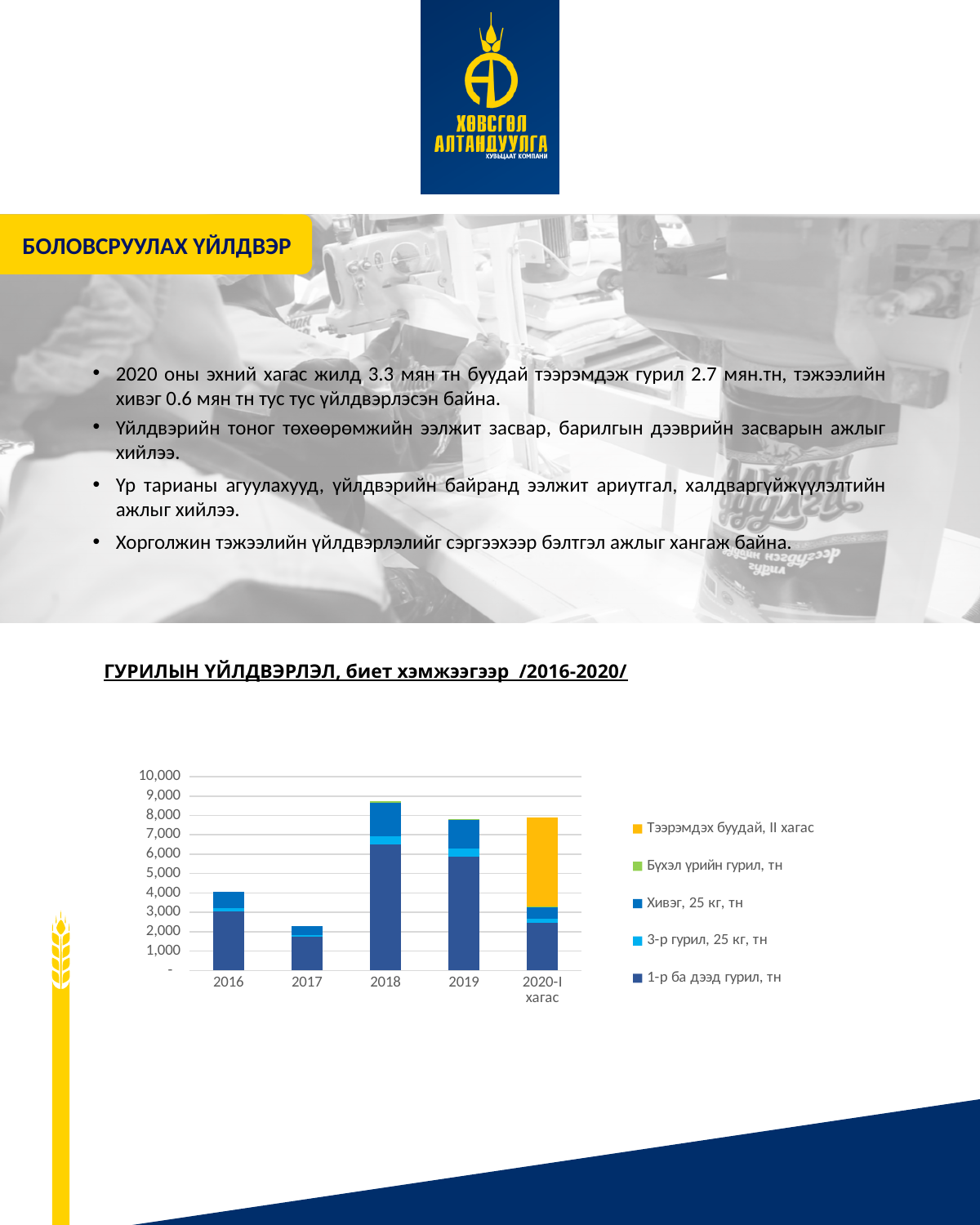
What is the title of the chart? ГУРИЛЫН ҮЙЛДВЭРЛЭЛ, биет хэмжээгээр /2016-2020/ Which has the larger total bar, 2018 or 2017? 2018 How many series does the chart's legend list? 5 What kind of chart is shown on the slide? Stacked bar chart Which year has the lowest total bar in the chart? 2017 Is the total value for 2016 greater or less than 3,000? greater Which year has the highest total bar in the chart? 2018 Is the total value for 2019 greater or less than 7,000? greater How many categories are shown on the x axis of the chart? 5 Is the total value for 2018 greater or less than 8,000? greater Which series is shown in yellow in the chart's legend? Тээрэмдэх буудай, II хагас